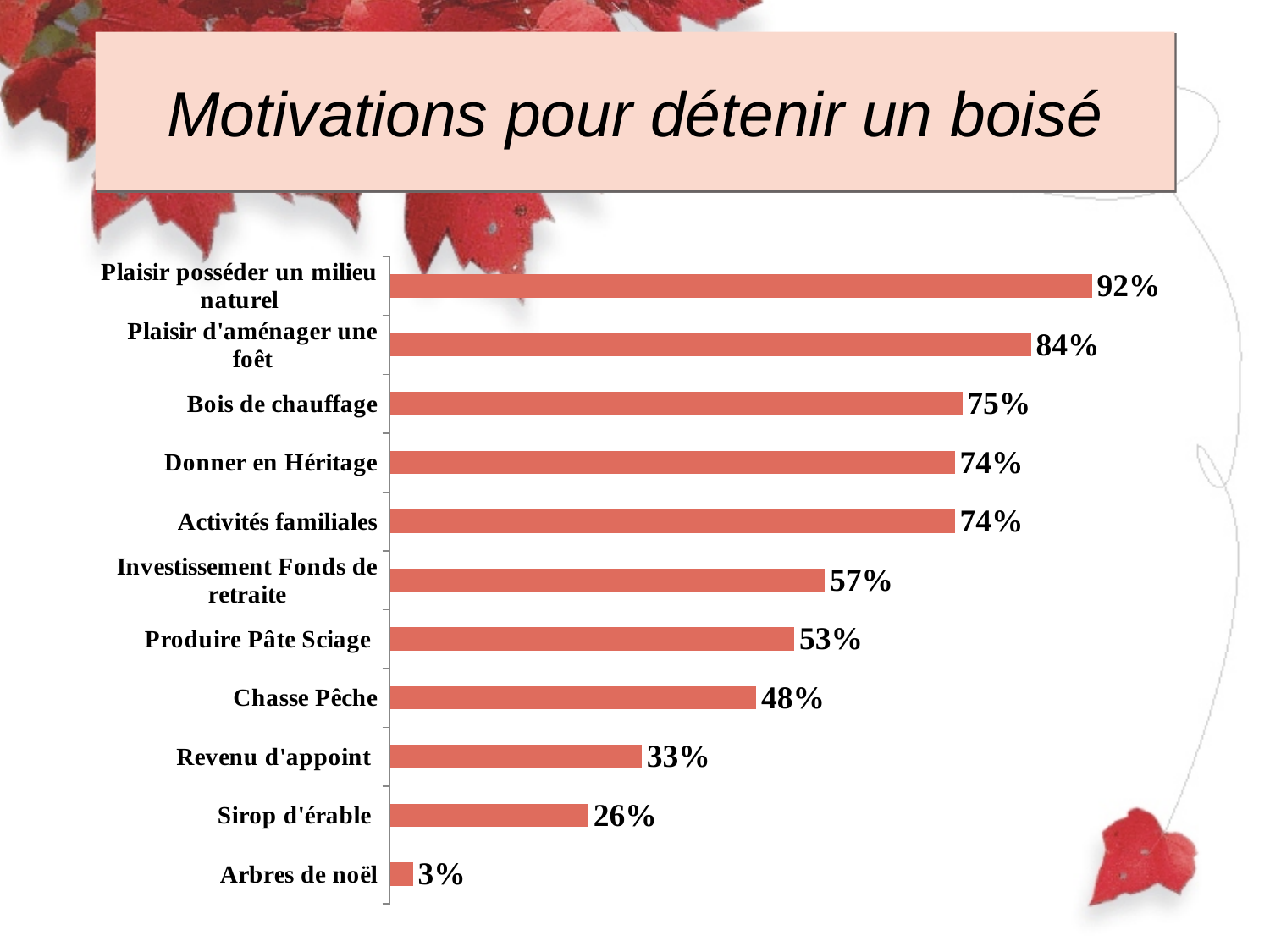
What kind of chart is shown on the slide? Bar chart Which category has the highest value? Plaisir posséder un milieu naturel What is the value for Chasse Pêche? 48% What is the title of the slide? Motivations pour détenir un boisé Which is larger, the value for Produire Pâte Sciage or the value for Chasse Pêche? Produire Pâte Sciage How many categories are shown in the chart? 11 What is the difference between the values for Investissement Fonds de retraite and Revenu d'appoint? 24% What is the value for Bois de chauffage? 75% Which is larger, the value for Sirop d'érable or the value for Revenu d'appoint? Revenu d'appoint Which category has the lowest value? Arbres de noël What is the value for Sirop d'érable? 26% What is the difference between the values for Plaisir posséder un milieu naturel and Plaisir d'aménager une foêt? 8%